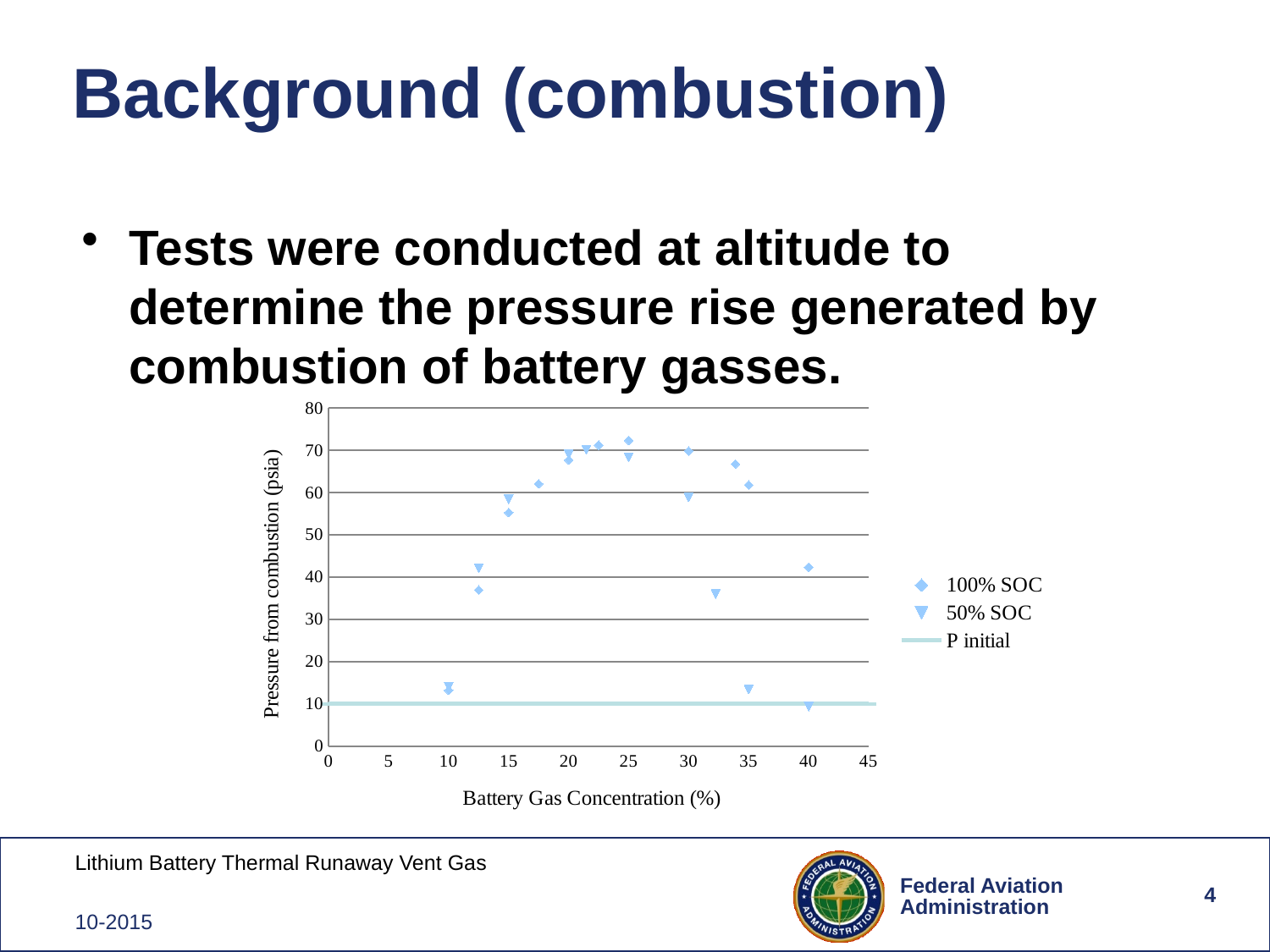
What kind of chart is shown on the slide? scatter chart Which series contains the highest pressure point on the chart? 100% SOC At a battery gas concentration of 35%, which series has the higher pressure, 100% SOC or 50% SOC? 100% SOC What is the title of the chart's x axis? Battery Gas Concentration (%) Is the 100% SOC value at a battery gas concentration of 25% greater or less than 70? greater Is the 50% SOC value at a battery gas concentration of about 32% greater or less than 40? less Is the 100% SOC value at a battery gas concentration of 15% greater or less than 50? greater At what pressure does the P initial line sit? 10 What is the title of the chart's y axis? Pressure from combustion (psia) How many series does the chart legend list? 3 At a battery gas concentration of 30%, which series has the higher pressure, 100% SOC or 50% SOC? 100% SOC